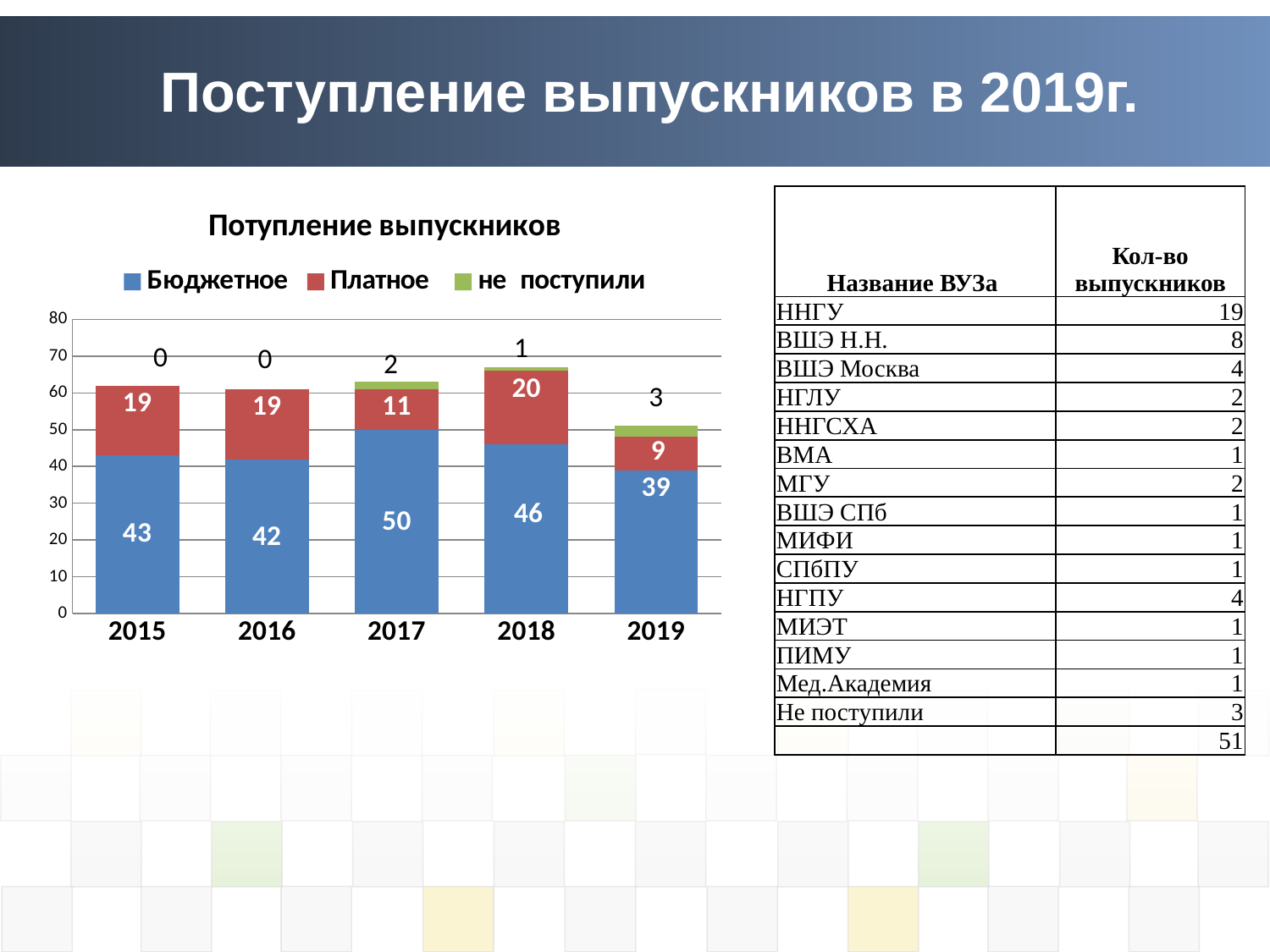
What type of chart is shown on the slide? stacked bar chart How many series does the chart legend list? 3 How many years are shown on the x axis of the chart? 5 What is the value of Бюджетное for 2017? 50 In which year is the Бюджетное value the highest? 2017 In which year is the Платное value the lowest? 2019 What is the value of не поступили for 2019? 3 What is the difference between the Бюджетное values for 2017 and 2019? 11 What is the total of the stacked bar for 2018? 67 What is the title of the chart? Потупление выпускников What is the value of Платное for 2018? 20 Which is larger, the Платное value for 2018 or for 2017? 2018